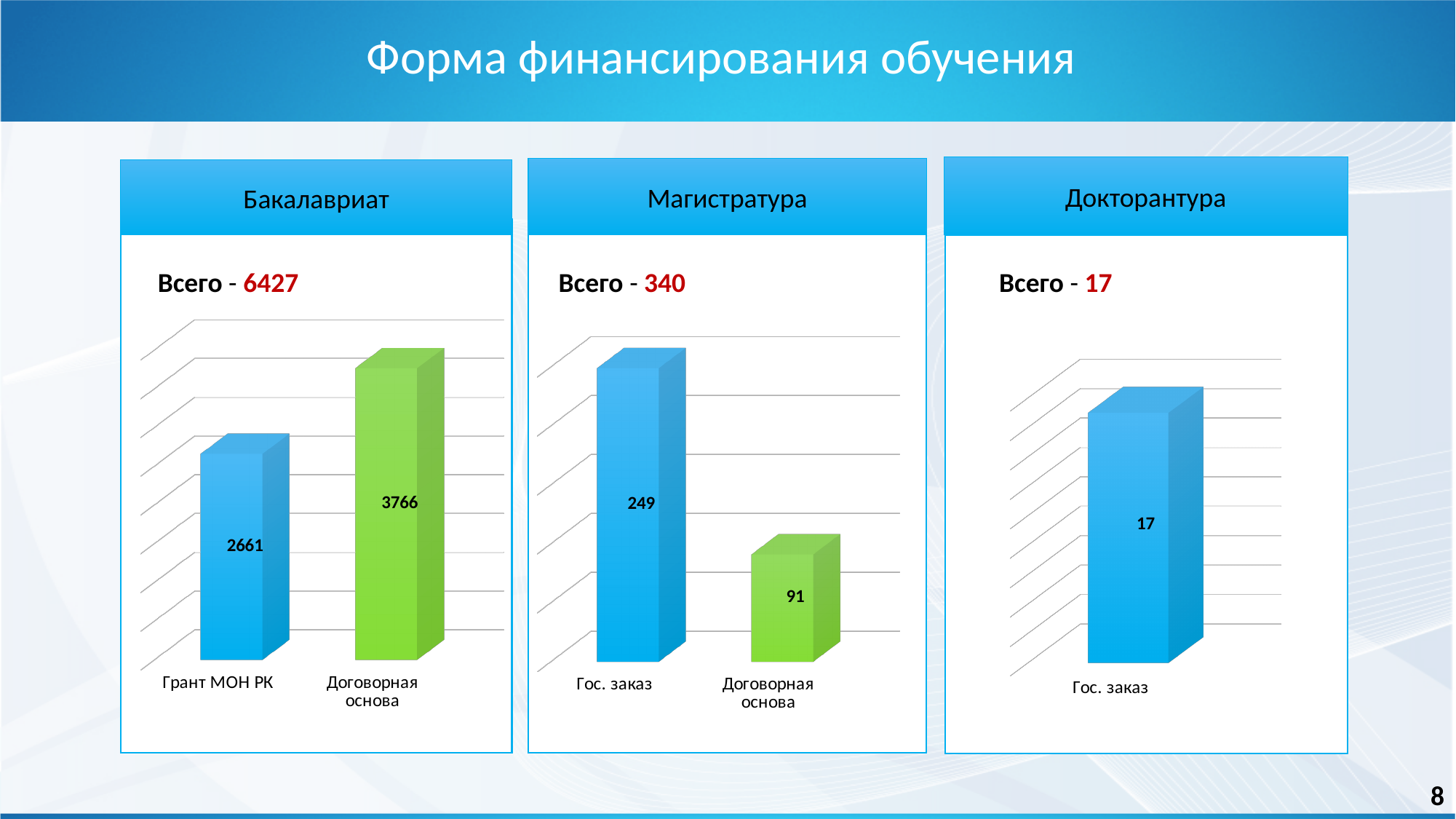
In the Докторантура chart, what is the value for Гос. заказ? 17 In the Магистратура chart, what is the difference between Гос. заказ and Договорная основа? 158 In the Бакалавриат chart, what is the difference between Договорная основа and Грант МОН РК? 1105 In the Магистратура chart, what is the value for Договорная основа? 91 In the Бакалавриат chart, what is the value for Договорная основа? 3766 In the Магистратура chart, which category has the lowest value? Договорная основа In the Магистратура chart, what is the value for Гос. заказ? 249 What type of chart is used in the Бакалавриат panel? Bar chart How many bars are in the Докторантура chart? 1 In the Бакалавриат chart, what is the value for Грант МОН РК? 2661 In the Бакалавриат chart, which category has the highest value? Договорная основа What total (Всего) is shown for the Магистратура chart? 340